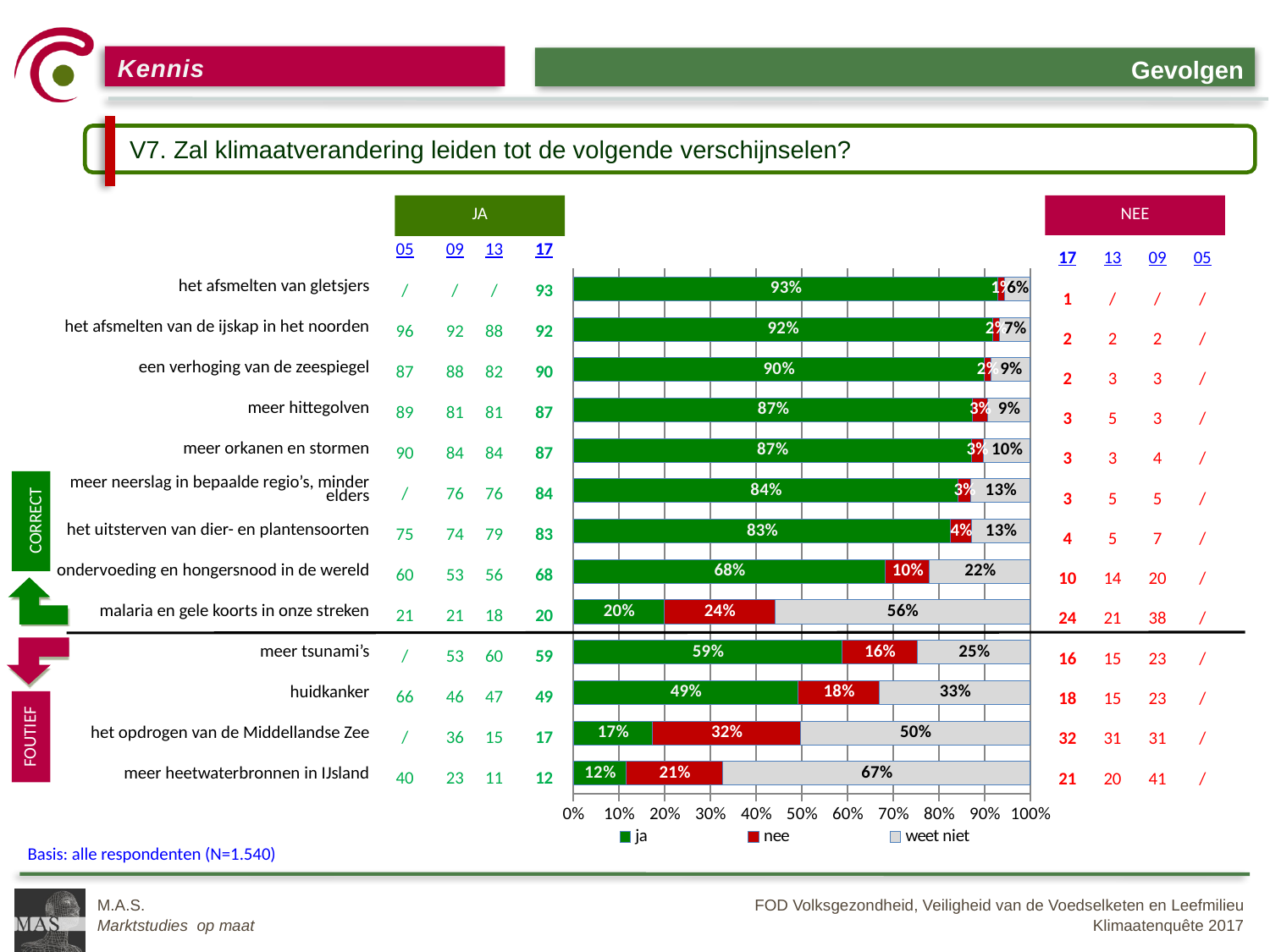
How many categories (statements) are plotted in the chart? 13 What is the 'nee' value for 'het opdrogen van de Middellandse Zee'? 32% Which category has the lowest 'ja' value? meer heetwaterbronnen in IJsland How many series does the chart legend list? 3 What is the 'ja' value for 'het afsmelten van gletsjers'? 93% What is the difference between the 'ja' values for 'huidkanker' and 'meer tsunami's'? 10% What is the 'weet niet' value for 'meer heetwaterbronnen in IJsland'? 67% Which is larger: the 'weet niet' value for 'malaria en gele koorts in onze streken' or for 'huidkanker'? malaria en gele koorts in onze streken Which series is shown in red in the chart? nee What type of chart is shown on the slide? stacked bar chart Is the 'ja' value for 'ondervoeding en hongersnood in de wereld' greater or less than 60%? greater Which category has the highest 'ja' value? het afsmelten van gletsjers